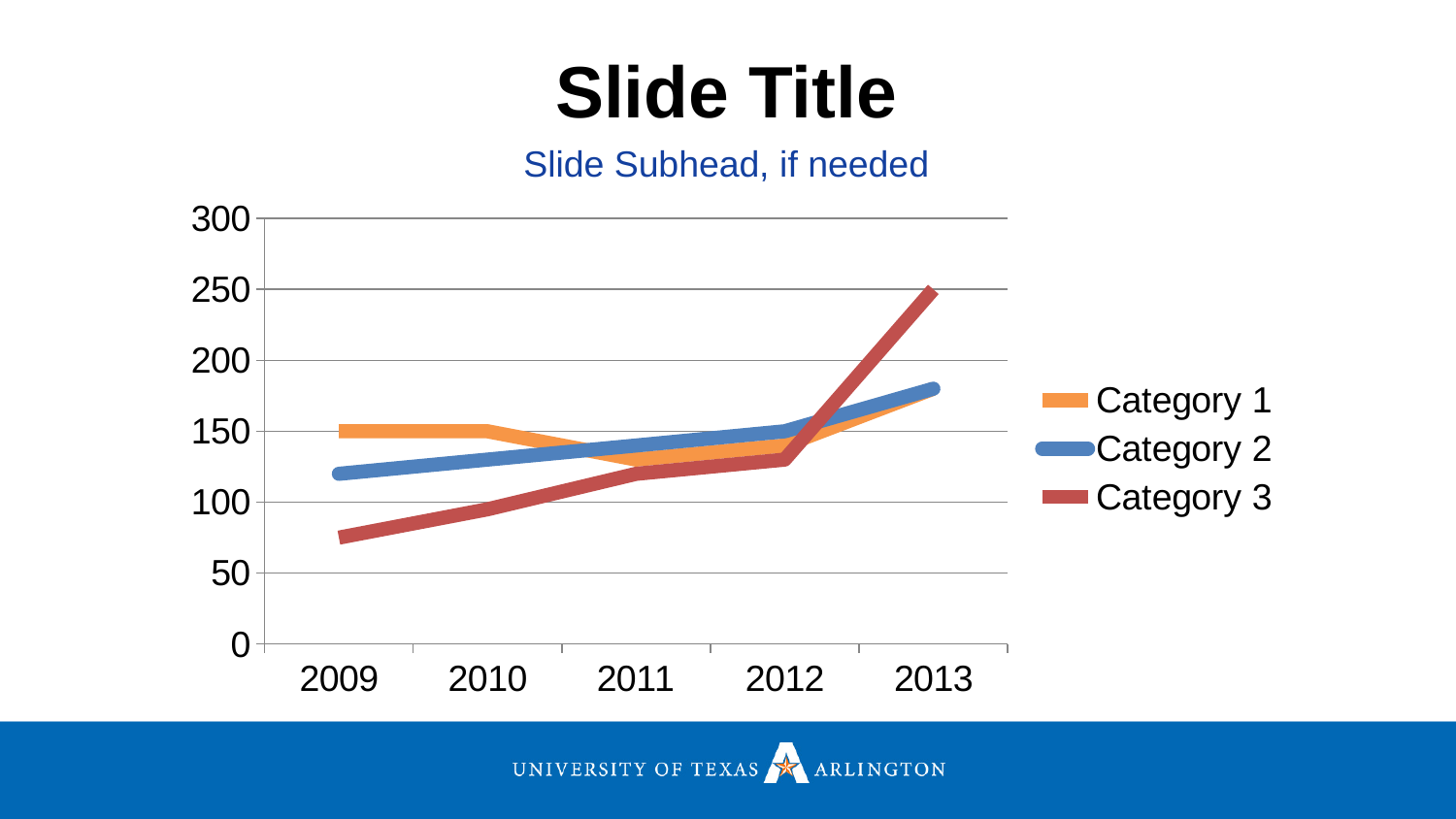
Is the value for Category 3 in 2009 greater or less than 100? less Do the values for Category 2 rise or fall from 2009 to 2013? rise Which series has the highest value in 2013? Category 3 How many years are shown on the x axis? 5 Do the values for Category 3 rise or fall from 2009 to 2013? rise How many series does the legend list? 3 Is the value for Category 3 in 2013 greater or less than 200? greater Which series has the lowest value in 2009? Category 3 In 2009, which is larger: Category 1 or Category 2? Category 1 What kind of chart is shown on the slide? line chart Is the value for Category 2 in 2009 greater or less than 100? greater What is the first year shown on the x axis? 2009